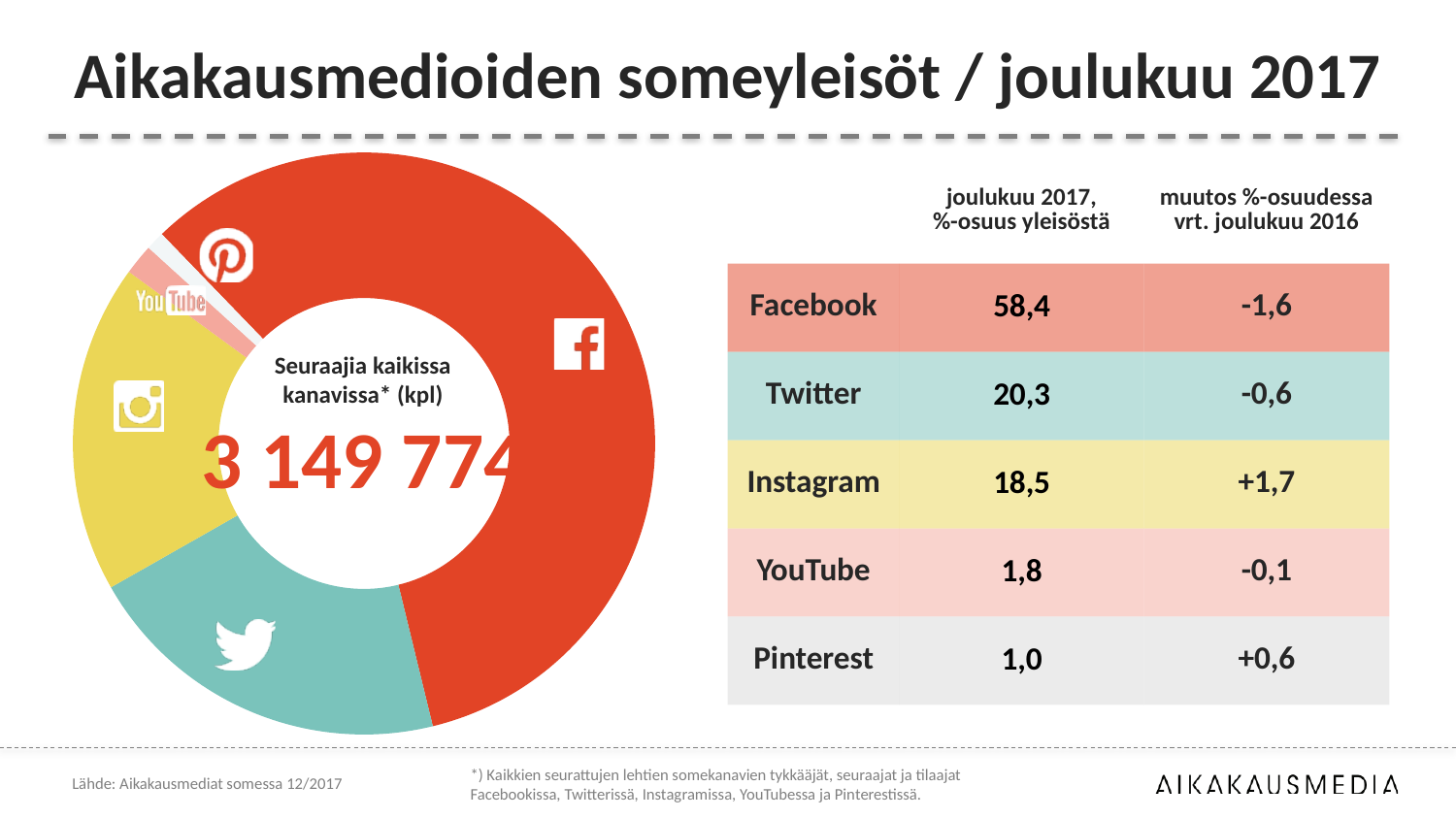
What is the difference between Facebook's and Twitter's share of the audience in December 2017? 38,1 Which slice is larger in the donut chart, Twitter or Instagram? Twitter What kind of chart is shown on the left of the slide? Donut (pie) chart What is Instagram's share of the audience in December 2017? 18,5 Which channel has the largest slice of the donut chart? Facebook What total number of followers across all channels is printed in the centre of the donut chart? 3 149 774 Which channel has the smallest slice of the donut chart? Pinterest What is Twitter's share of the audience in December 2017? 20,3 Which channel's share decreased the most compared with December 2016? Facebook How many social media channels are shown as slices in the donut chart? 5 What is the change in Instagram's share compared with December 2016? +1,7 What is Facebook's share of the audience in December 2017 according to the table? 58,4